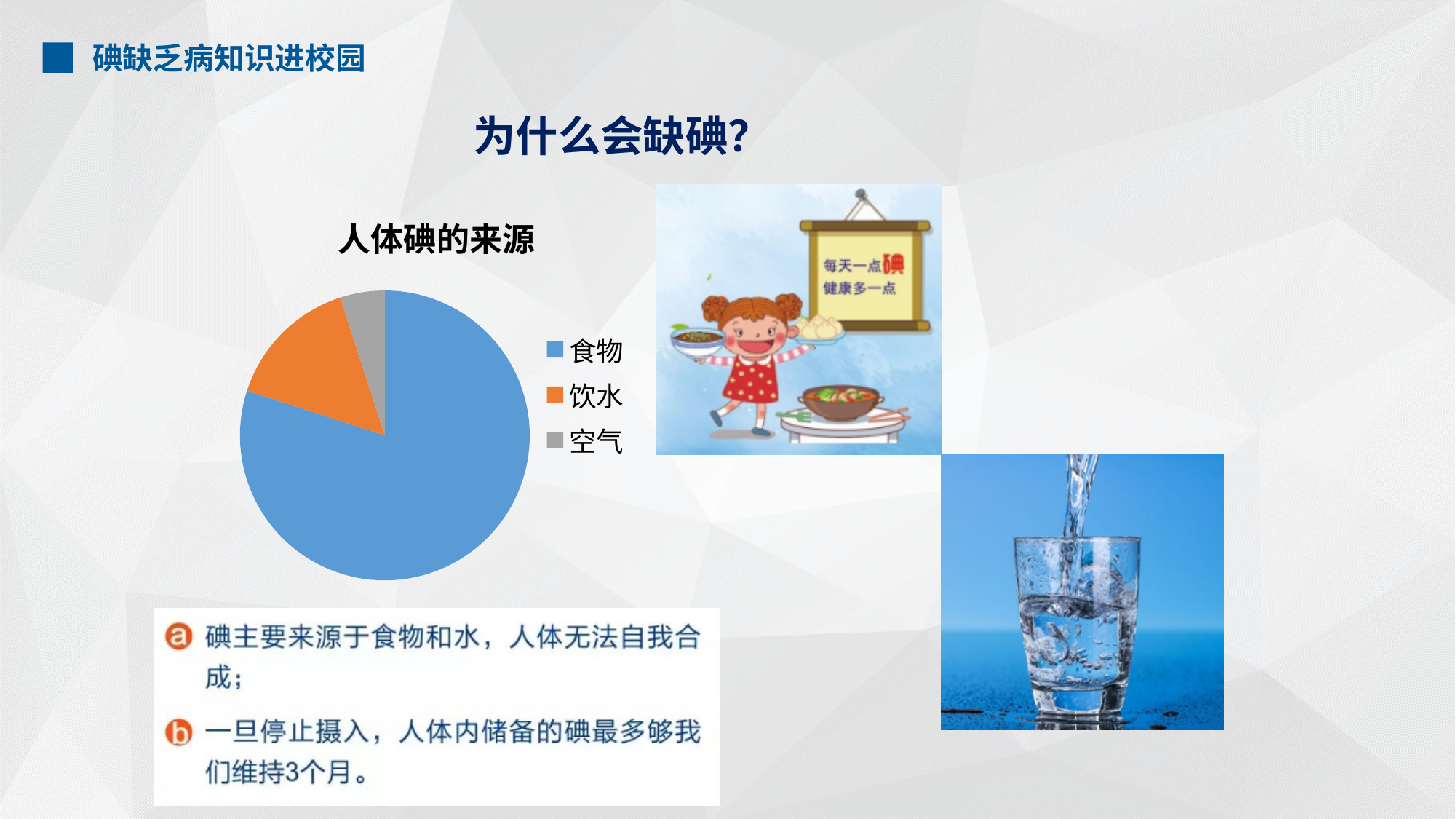
What is the title of the pie chart? 人体碘的来源 What kind of chart is shown on the slide? pie chart Which category has the largest slice in the pie chart? 食物 What colour is the 食物 slice in the pie chart? blue How many categories does the pie chart show? 3 Which slice is larger in the pie chart, 食物 or 饮水? 食物 Which category has the smallest slice in the pie chart? 空气 Which slice is larger in the pie chart, 饮水 or 空气? 饮水 Which categories are listed in the legend of the pie chart? 食物, 饮水, 空气